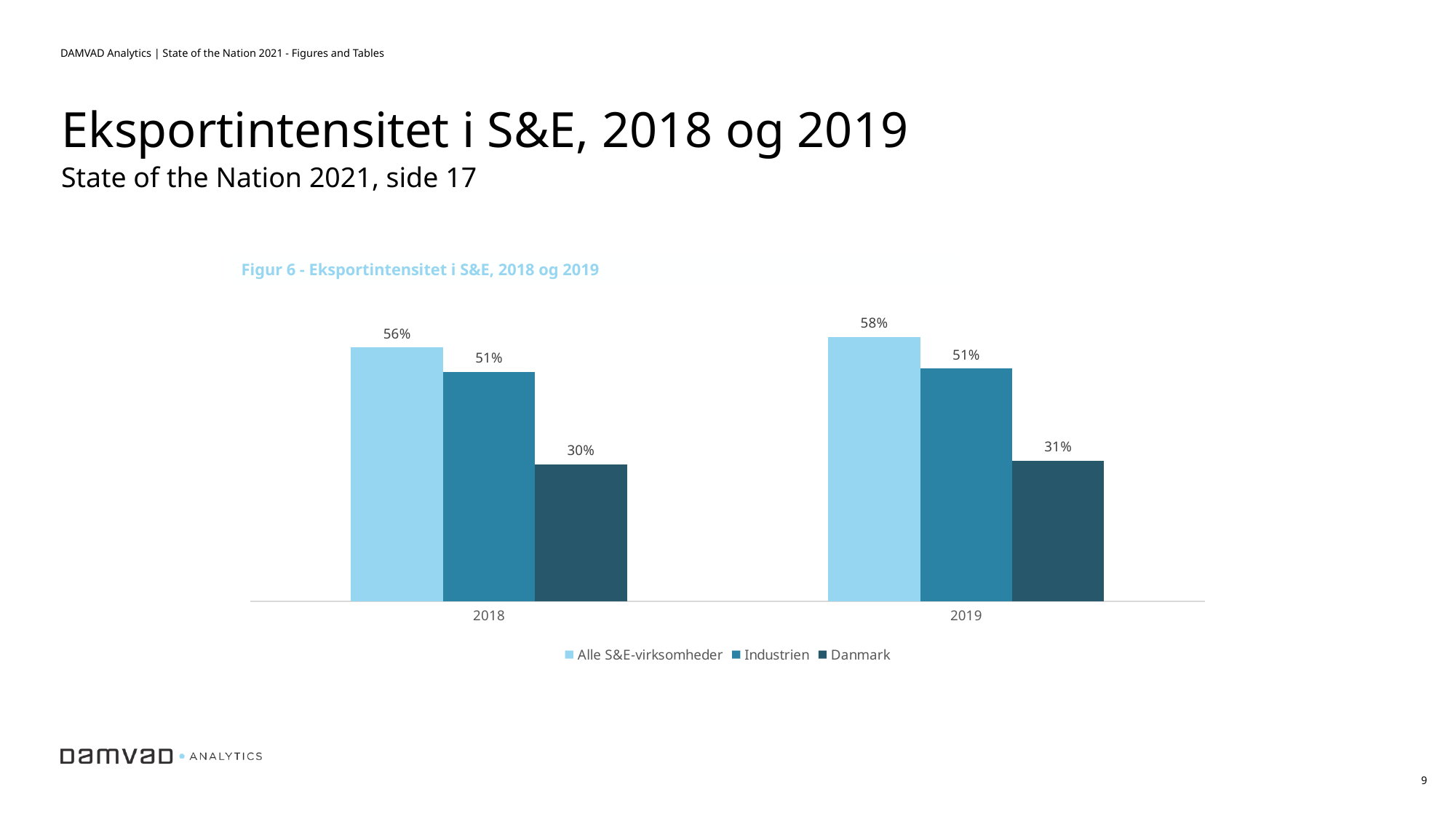
Which series has the lowest value in 2018? Danmark What is the title of the figure? Figur 6 - Eksportintensitet i S&E, 2018 og 2019 How many series does the legend list? 3 Which is larger: Industrien in 2018 or Danmark in 2019? Industrien in 2018 How many year categories are shown on the x axis? 2 What is the value for Industrien in 2019? 51% What is the difference between Alle S&E-virksomheder and Danmark in 2018? 26 percentage points What is the difference between the Alle S&E-virksomheder values for 2019 and 2018? 2 percentage points What kind of chart is shown? Bar chart Which series has the highest value in 2019? Alle S&E-virksomheder What is the value for Alle S&E-virksomheder in 2018? 56% What is the value for Danmark in 2019? 31%